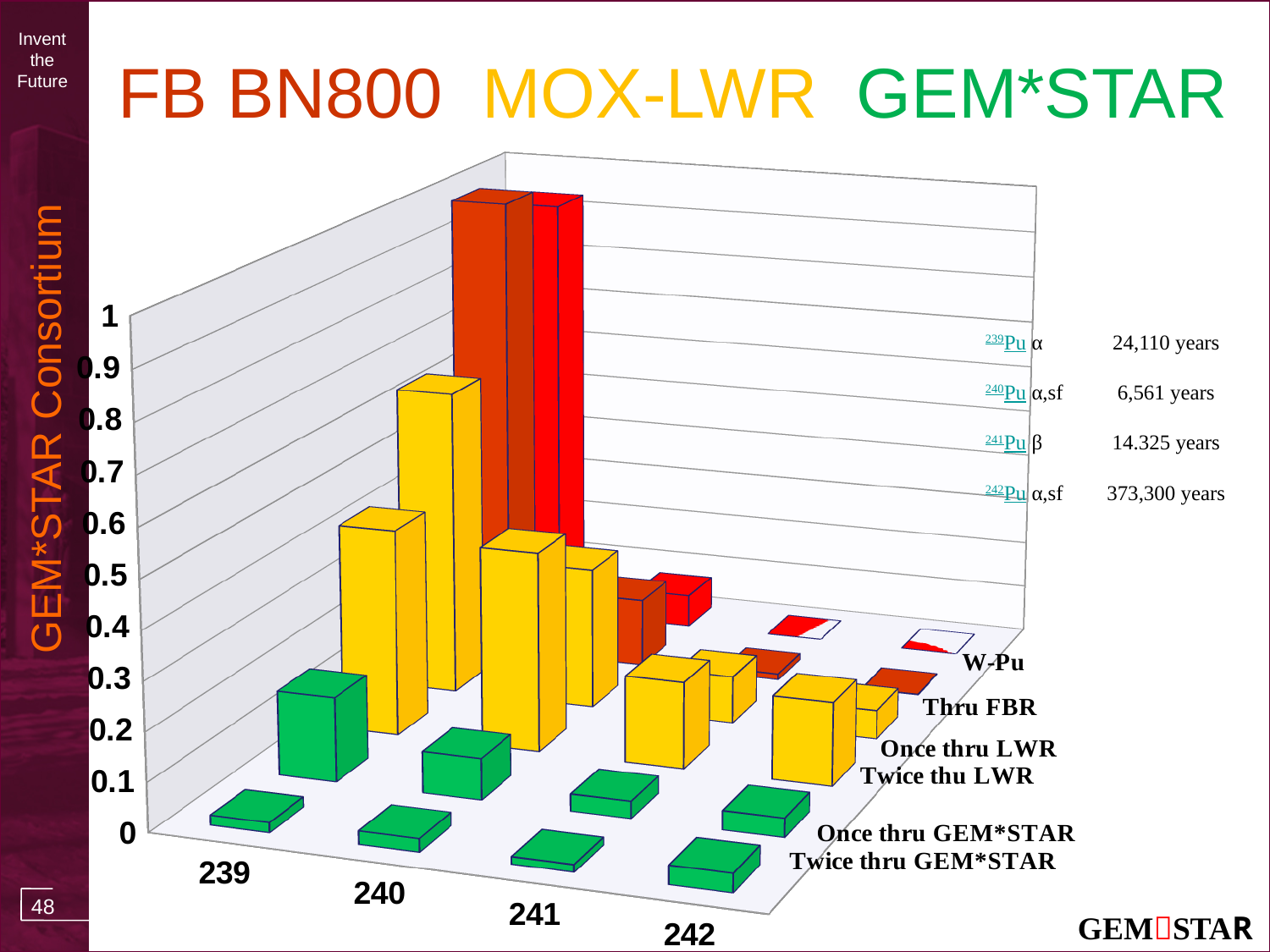
How many isotope categories are shown along the x axis of the chart? 4 Is the W-Pu value for 239 greater or less than 0.5? greater Which is larger for the Once thru GEM*STAR series: the value for 239 or the value for 241? 239 How many series (fuel cycle rows) does the chart show? 6 What kind of chart is shown on the slide? bar chart What colour are the bars for the GEM*STAR series in the chart? green What is the title text shown above the chart? FB BN800 MOX-LWR GEM*STAR For the W-Pu series, which isotope category has the highest bar? 239 Which is larger for the W-Pu series: the value for 239 or the value for 242? 239 Is the Twice thru GEM*STAR value for 239 greater or less than 0.1? less